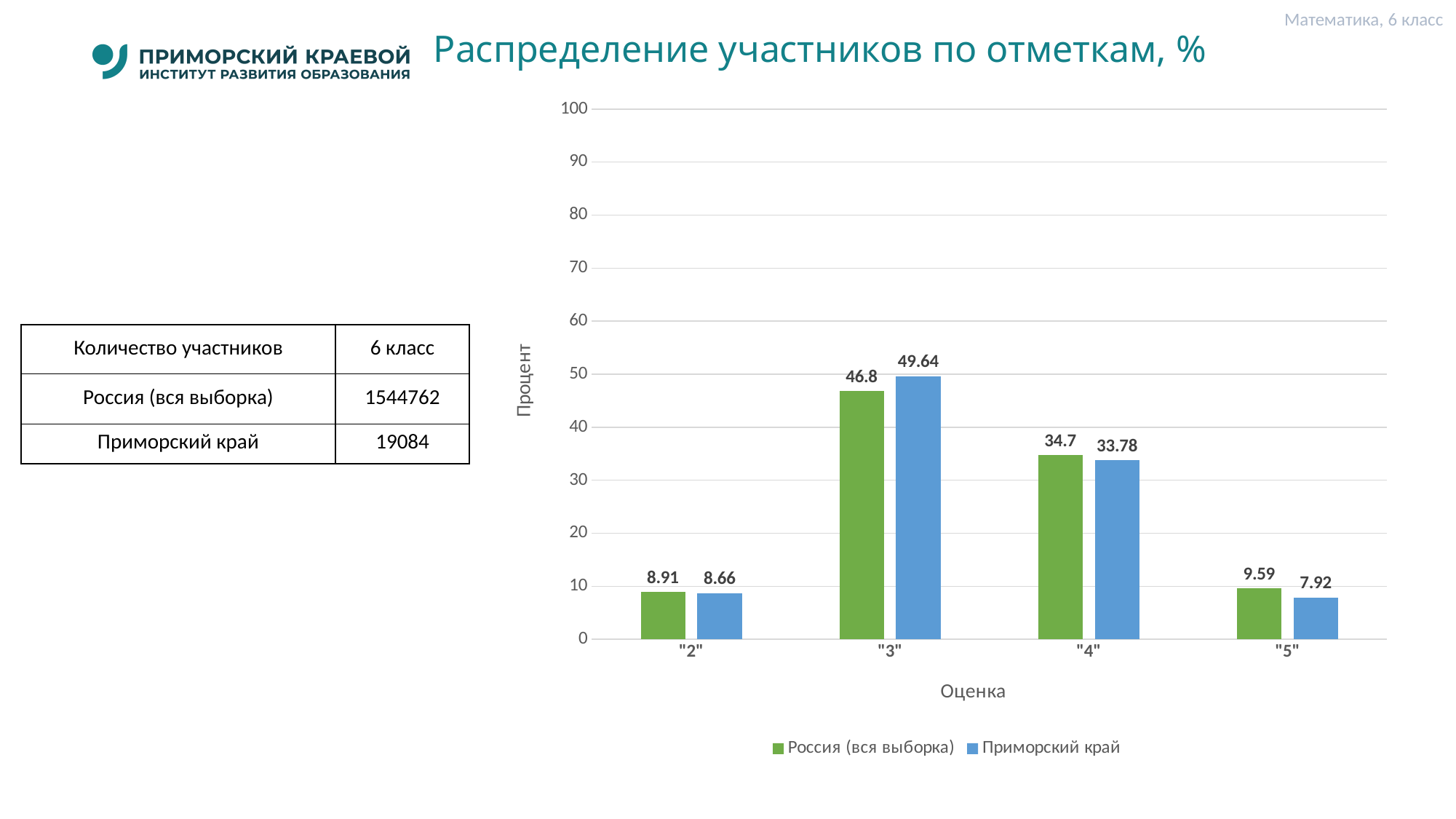
How many grade categories are shown on the x axis? 4 Which grade has the highest value for Приморский край? "3" What is the value for Приморский край for grade "5"? 7.92 How many series does the legend list? 2 What is the title of the chart? Распределение участников по отметкам, % What is the difference between Приморский край and Россия (вся выборка) for grade "3"? 2.84 For grade "4", which series has the larger value: Россия (вся выборка) or Приморский край? Россия (вся выборка) What kind of chart is shown on the slide? bar chart What is the value for Приморский край for grade "4"? 33.78 Is the value for Россия (вся выборка) for grade "2" greater or less than 10? less Which grade has the lowest value for Приморский край? "5" What is the value for Россия (вся выборка) for grade "3"? 46.8